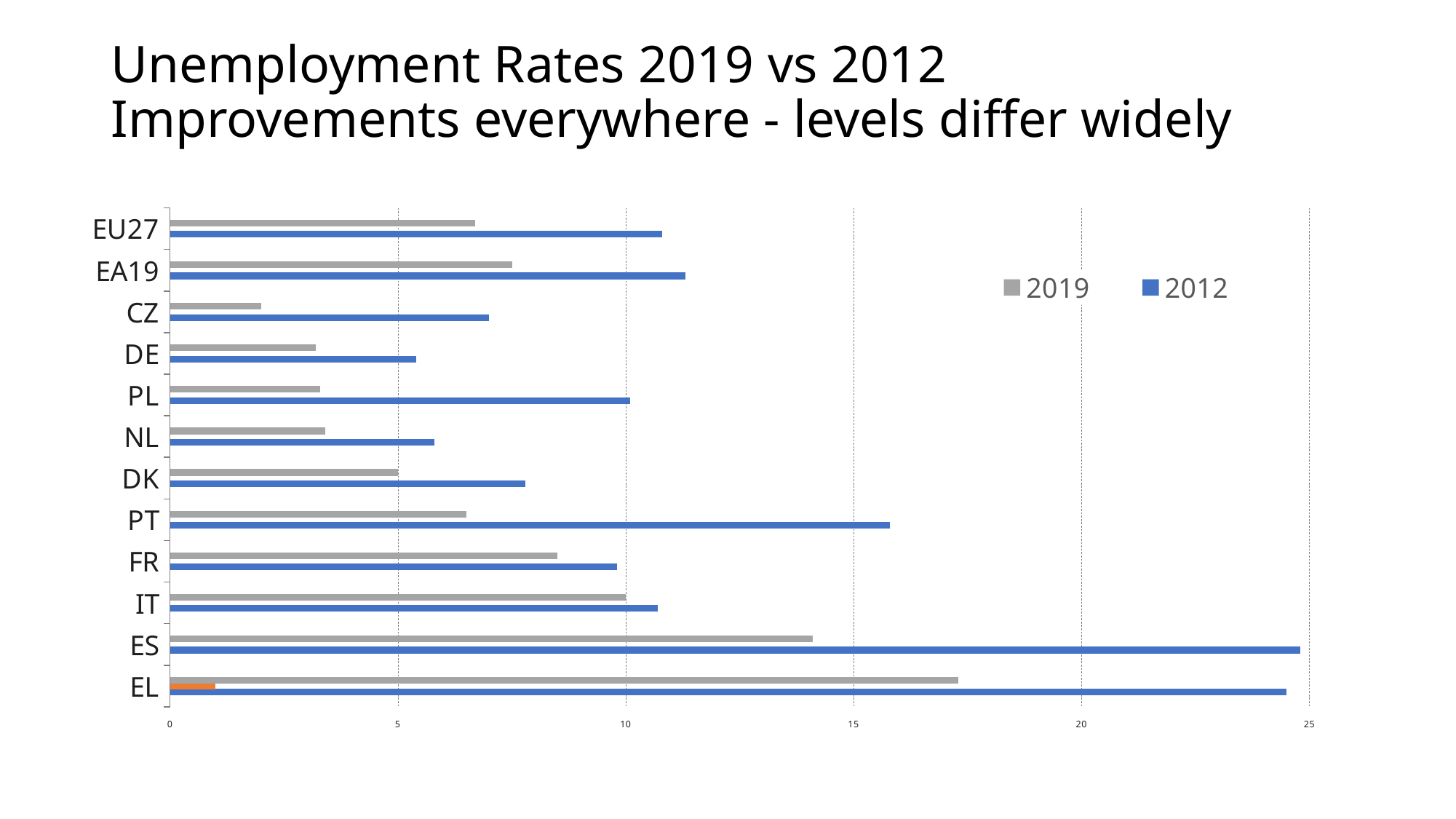
Which colour represents the 2012 series in the chart? Blue Is the 2019 value for EL greater or less than 15? greater Is the 2012 value for ES greater or less than 20? greater Is the 2012 value for DE greater or less than 10? less Which category has the highest 2019 unemployment rate? EL Which is larger, the 2012 value for PT or the 2012 value for FR? PT How many countries or regions are listed on the vertical axis of the chart? 12 Which category has the lowest 2019 unemployment rate? CZ Which is larger, the 2019 value for ES or the 2019 value for IT? ES How many series does the chart's legend list? 2 What kind of chart is shown on the slide? Bar chart